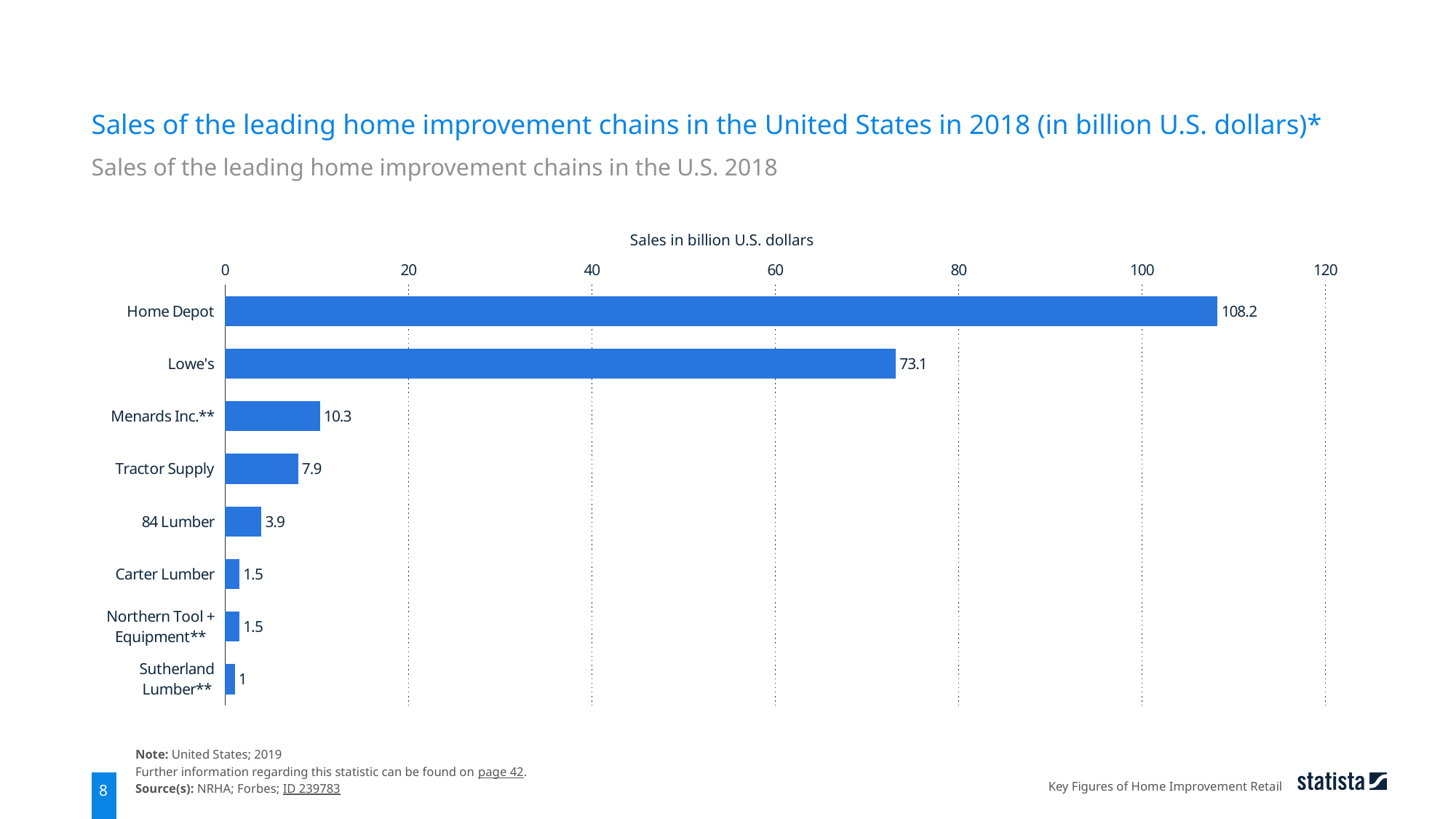
Is the value for Lowe's greater or less than 80? less Which had higher sales, Menards Inc.** or Tractor Supply? Menards Inc.** Which chain had the highest sales? Home Depot What is the difference in sales between Home Depot and Lowe's, in billion U.S. dollars? 35.1 What were Home Depot's sales in billion U.S. dollars? 108.2 What were Tractor Supply's sales in billion U.S. dollars? 7.9 How many home improvement chains are shown in the chart? 8 Which chain had the lowest sales? Sutherland Lumber** What is the label of the horizontal axis? Sales in billion U.S. dollars What kind of chart is shown on the slide? bar chart What were the sales of Menards Inc.** in billion U.S. dollars? 10.3 What were Lowe's sales in billion U.S. dollars? 73.1